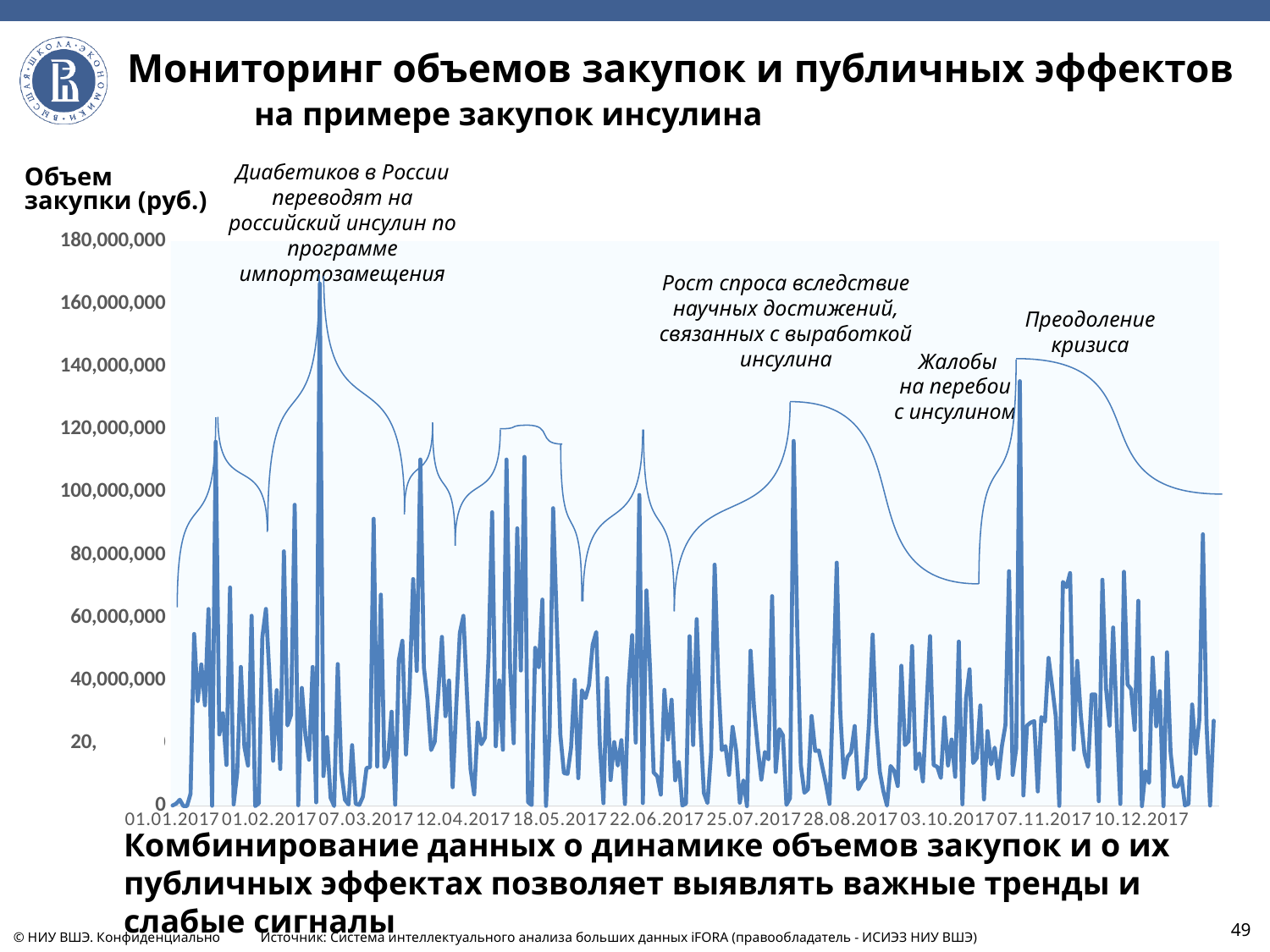
How many date labels are shown along the horizontal axis of the chart? 11 What is the first date label on the horizontal axis of the chart? 01.01.2017 Is the value of the line at 01.01.2017 greater or less than 20,000,000? less What is the highest value shown on the vertical axis of the chart? 180,000,000 Is the spike in the line shortly after 07.11.2017 greater or less than 120,000,000? greater Is the highest peak of the line greater or less than 180,000,000? less What is the label of the vertical axis of the chart? Объем закупки (руб.) Which is larger: the peak of the line near 07.03.2017 or the peak shortly after 07.11.2017? the peak near 07.03.2017 What kind of chart is shown on the slide? line chart